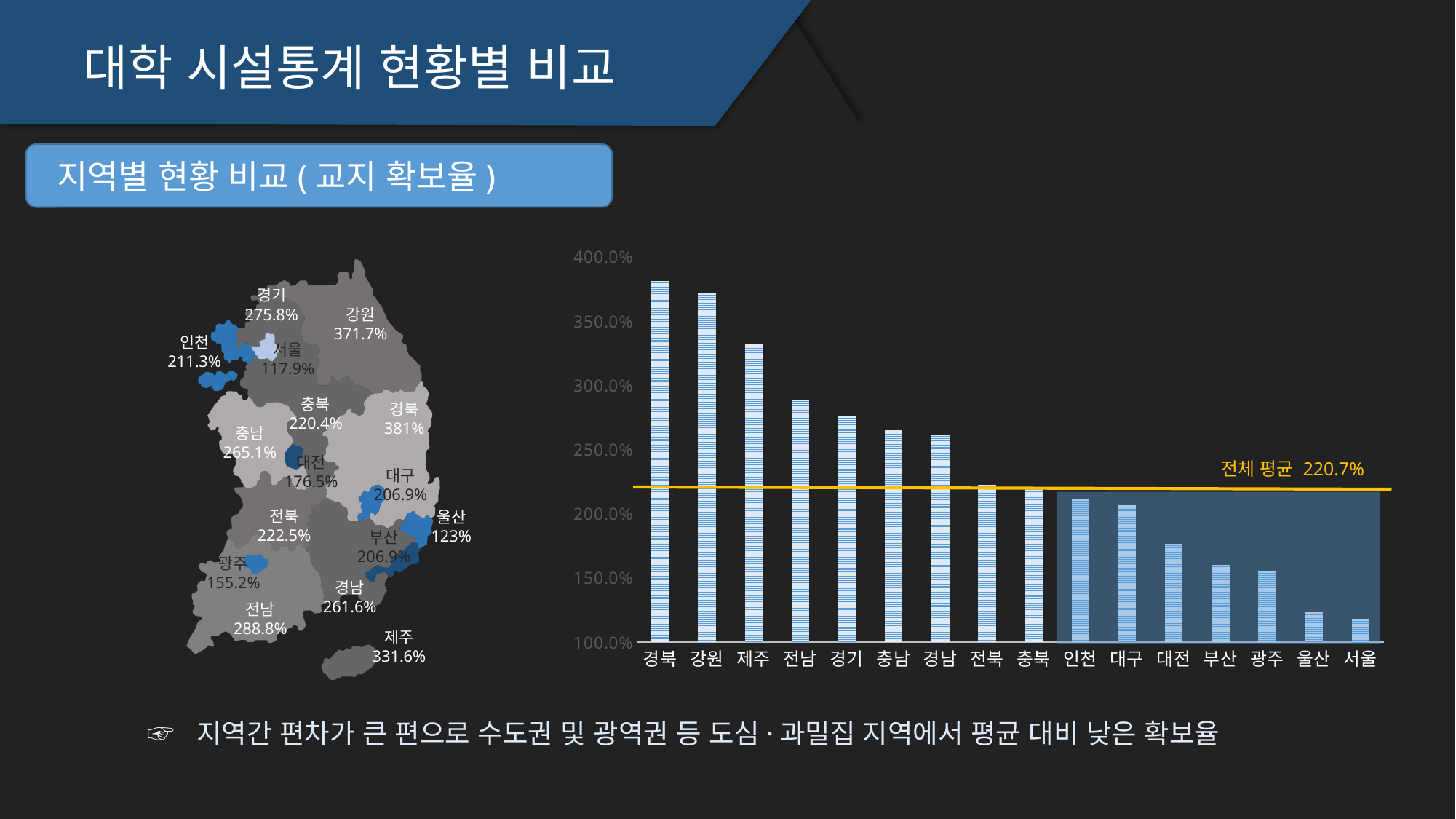
According to the map on the left, what is the value shown for 강원? 371.7% Is the bar for 대전 greater or less than 200.0%? less How many regions are shown on the x axis of the bar chart? 16 Do the bar values rise or fall from left to right along the x axis? fall Is the bar for 강원 greater or less than 350.0%? greater Which has the larger bar, 전남 or 충남? 전남 What kind of chart is shown on the right side of the slide? bar chart What is the overall average (전체 평균) value marked by the horizontal line on the bar chart? 220.7% Is the bar for 제주 greater or less than 300.0%? greater Which region has the highest bar in the bar chart? 경북 Which region has the lowest bar in the bar chart? 서울